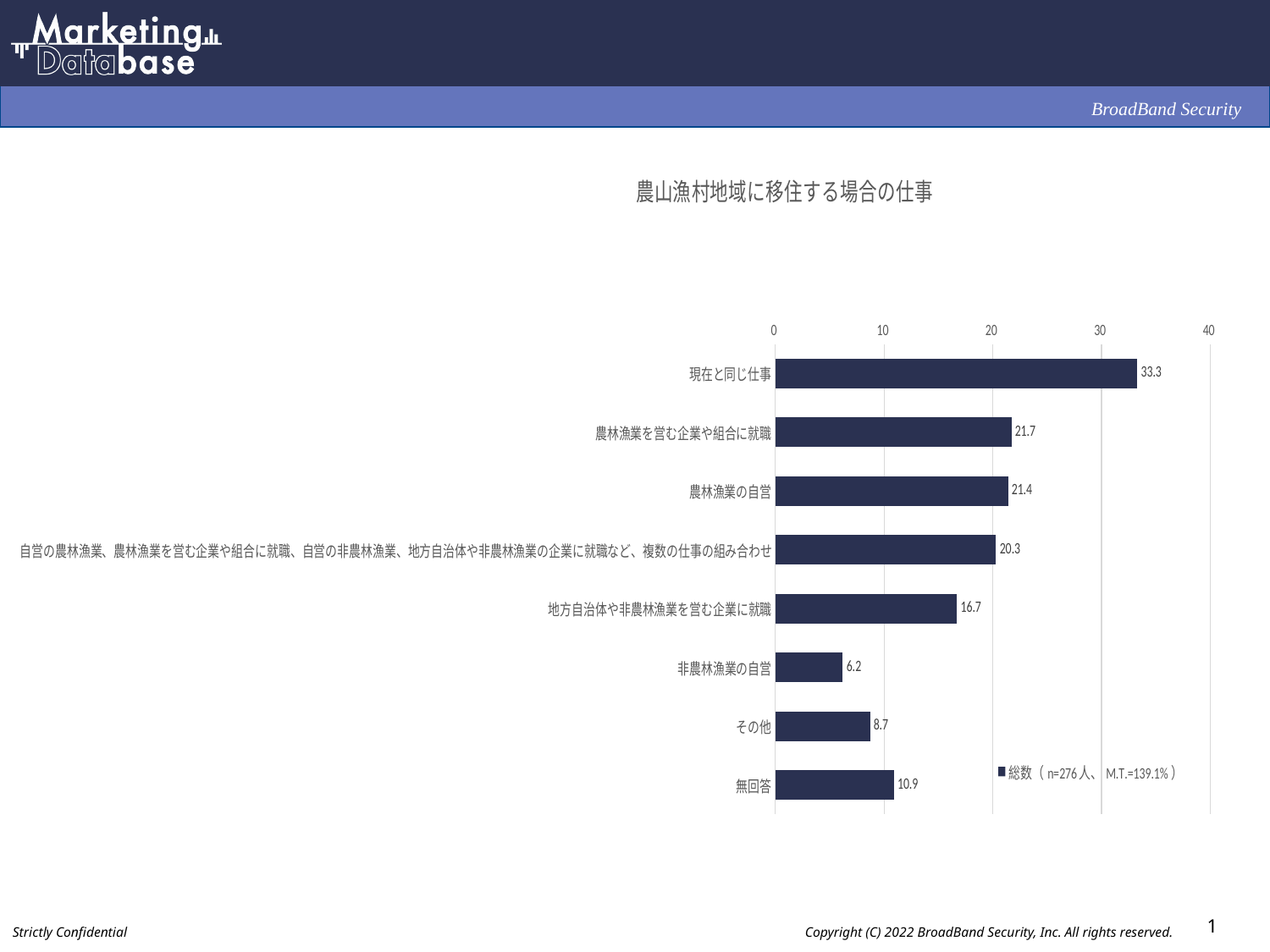
What is the value for 無回答? 10.9 Which category has the lowest value? 非農林漁業の自営 Which is larger, the value for その他 or the value for 非農林漁業の自営? その他 What kind of chart is shown on the slide? bar chart Which category has the highest value? 現在と同じ仕事 What is the value for 現在と同じ仕事? 33.3 What is the title of the chart? 農山漁村地域に移住する場合の仕事 How many categories are shown in the chart? 8 Is the value for 地方自治体や非農林漁業を営む企業に就職 greater or less than 20? less What is the difference between the values for 現在と同じ仕事 and 農林漁業の自営? 11.9 How many series does the legend list? 1 What is the value for 農林漁業を営む企業や組合に就職? 21.7